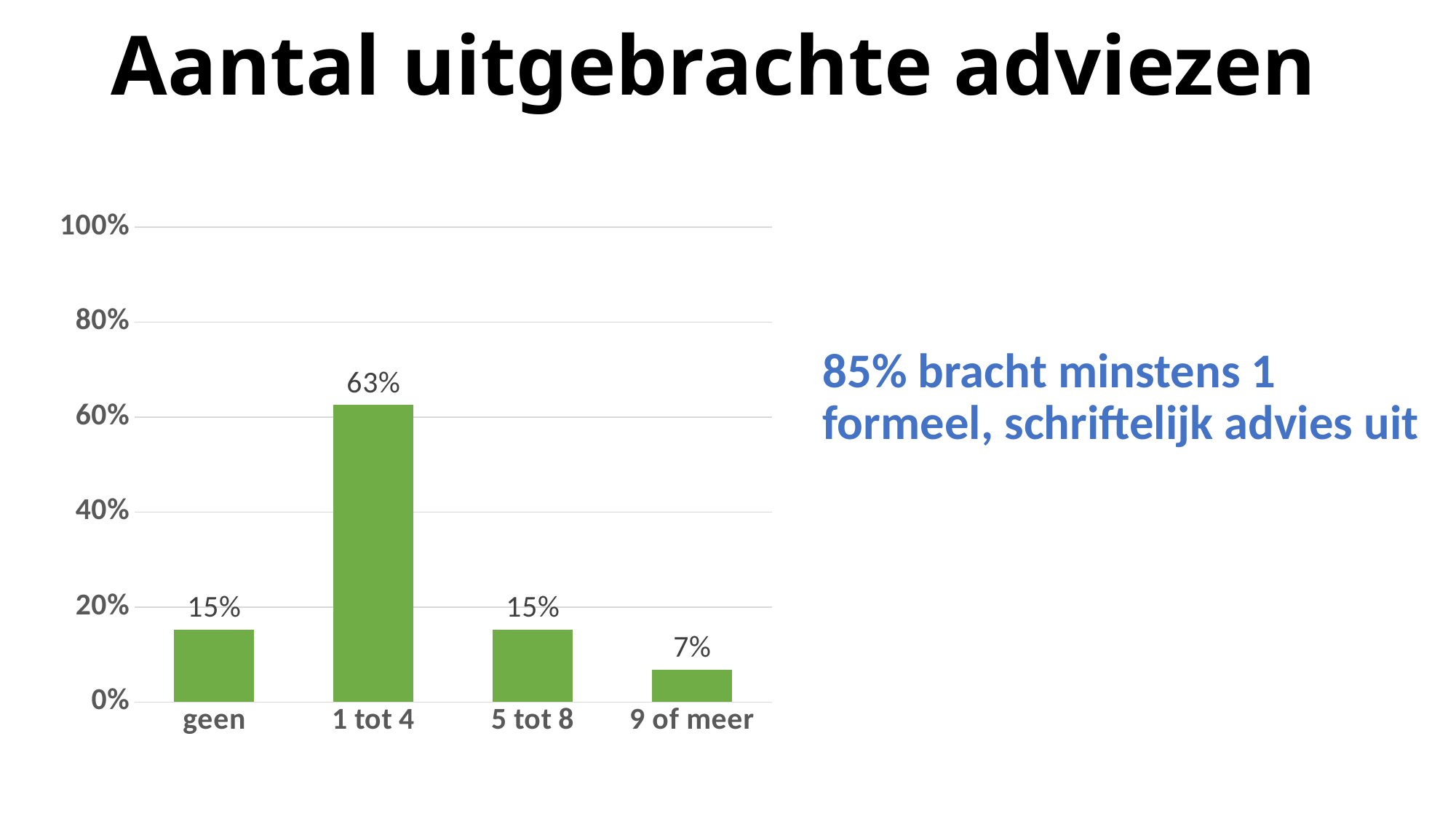
Is the value for '1 tot 4' greater or less than 60%? greater Which category has the highest value? 1 tot 4 What is the value for the '1 tot 4' category? 63% What kind of chart is shown on the slide? bar chart What is the difference between the values for 'geen' and '9 of meer'? 8% How many categories are shown on the x axis? 4 Which category has the lowest value? 9 of meer What is the value for the 'geen' category? 15% What is the difference between the values for '1 tot 4' and '5 tot 8'? 48% What is the value for the '9 of meer' category? 7% Which is larger, the value for '1 tot 4' or the value for '9 of meer'? 1 tot 4 What is the title of the slide containing the chart? Aantal uitgebrachte adviezen